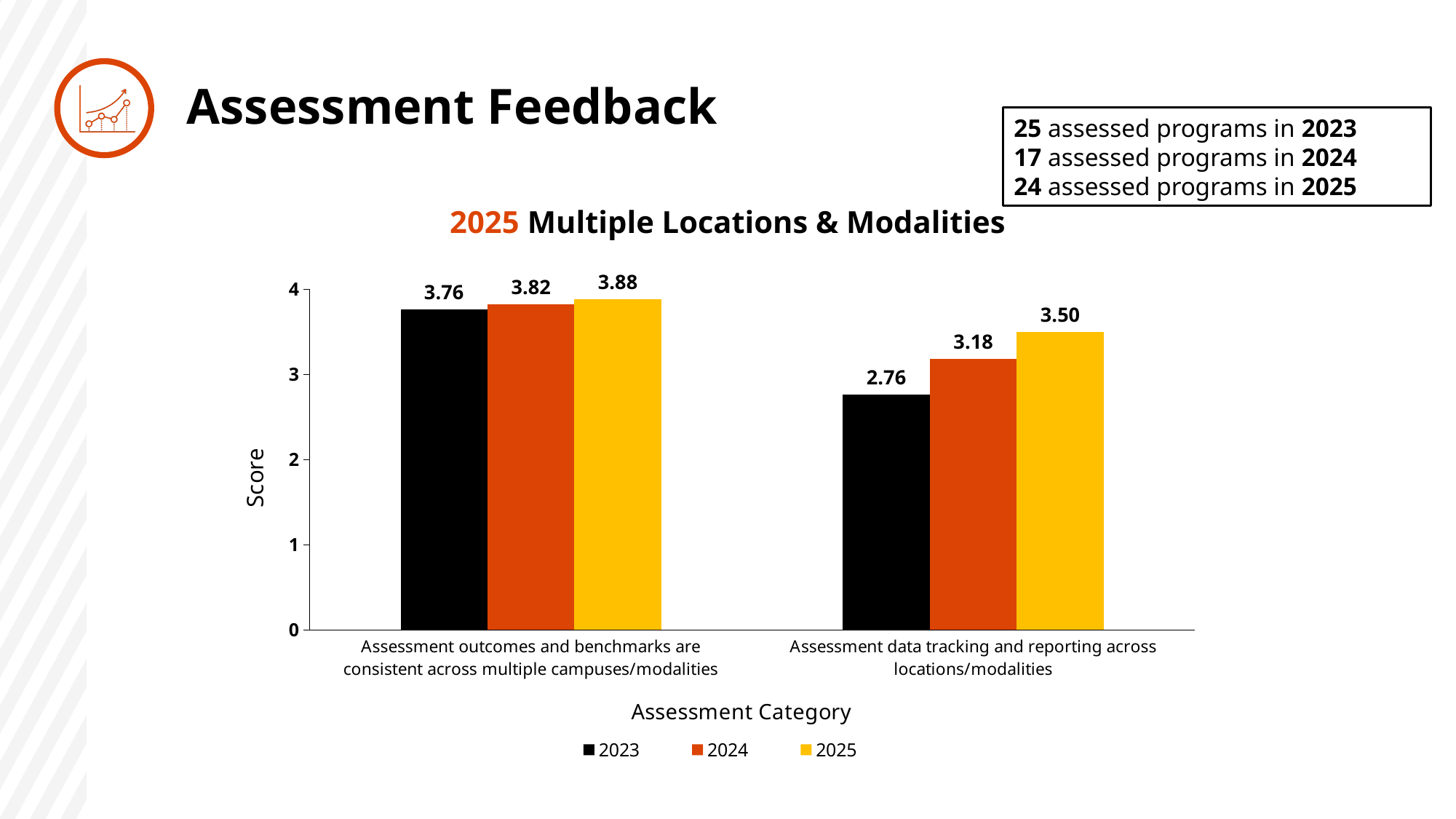
What is the 2024 score for 'Assessment data tracking and reporting across locations/modalities'? 3.18 What is the difference between the 2025 and 2024 scores for 'Assessment outcomes and benchmarks are consistent across multiple campuses/modalities'? 0.06 What is the title of the chart? 2025 Multiple Locations & Modalities What is the 2023 score for 'Assessment data tracking and reporting across locations/modalities'? 2.76 Which year has the highest score for 'Assessment data tracking and reporting across locations/modalities'? 2025 What is the difference between the 2025 and 2023 scores for 'Assessment data tracking and reporting across locations/modalities'? 0.74 How many series does the legend list? 3 What kind of chart is shown on the slide? Bar chart Which is larger: the 2024 score for 'Assessment outcomes and benchmarks are consistent across multiple campuses/modalities' or the 2024 score for 'Assessment data tracking and reporting across locations/modalities'? Assessment outcomes and benchmarks are consistent across multiple campuses/modalities What is the 2025 score for 'Assessment outcomes and benchmarks are consistent across multiple campuses/modalities'? 3.88 Which year has the lowest score for 'Assessment outcomes and benchmarks are consistent across multiple campuses/modalities'? 2023 How many assessment categories are shown on the x axis? 2